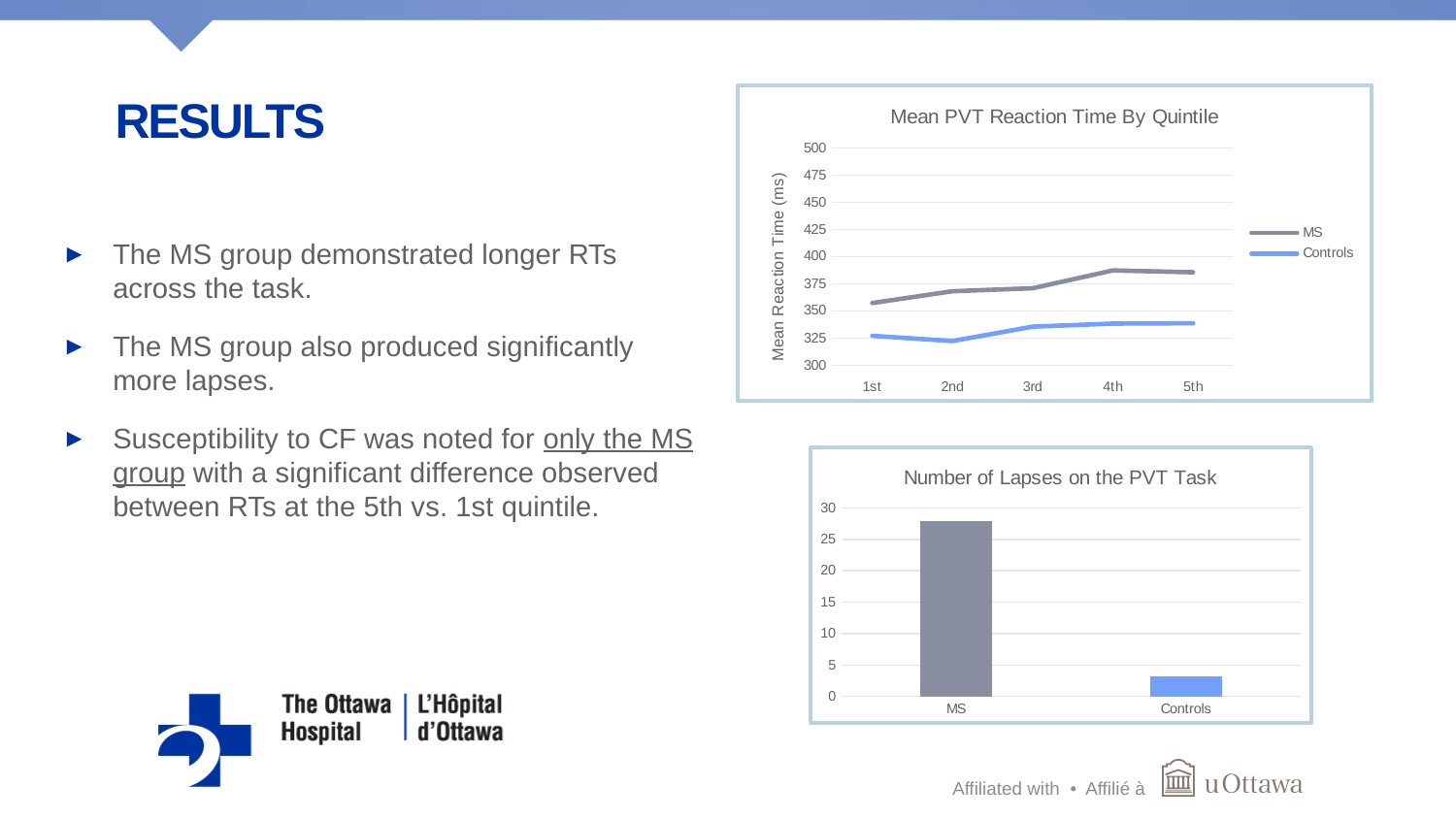
What kind of chart is "Mean PVT Reaction Time By Quintile"? line chart In the "Number of Lapses on the PVT Task" chart, which group has the highest number of lapses? MS In the "Mean PVT Reaction Time By Quintile" chart, which series has the higher reaction time at the 5th quintile, MS or Controls? MS In the "Mean PVT Reaction Time By Quintile" chart, does the MS series generally rise or fall from the 1st to the 5th quintile? rise In the "Mean PVT Reaction Time By Quintile" chart, how many quintile categories are shown on the x axis? 5 What kind of chart is "Number of Lapses on the PVT Task"? bar chart What is the label on the y axis of the "Mean PVT Reaction Time By Quintile" chart? Mean Reaction Time (ms) In the "Mean PVT Reaction Time By Quintile" chart, is the Controls value at the 2nd quintile greater or less than 350? less In the "Mean PVT Reaction Time By Quintile" chart, is the MS value at the 4th quintile greater or less than 375? greater In the "Mean PVT Reaction Time By Quintile" chart, how many series does the legend list? 2 In the "Number of Lapses on the PVT Task" chart, which group has the lowest number of lapses? Controls In the "Number of Lapses on the PVT Task" chart, is the value for MS greater or less than 25? greater